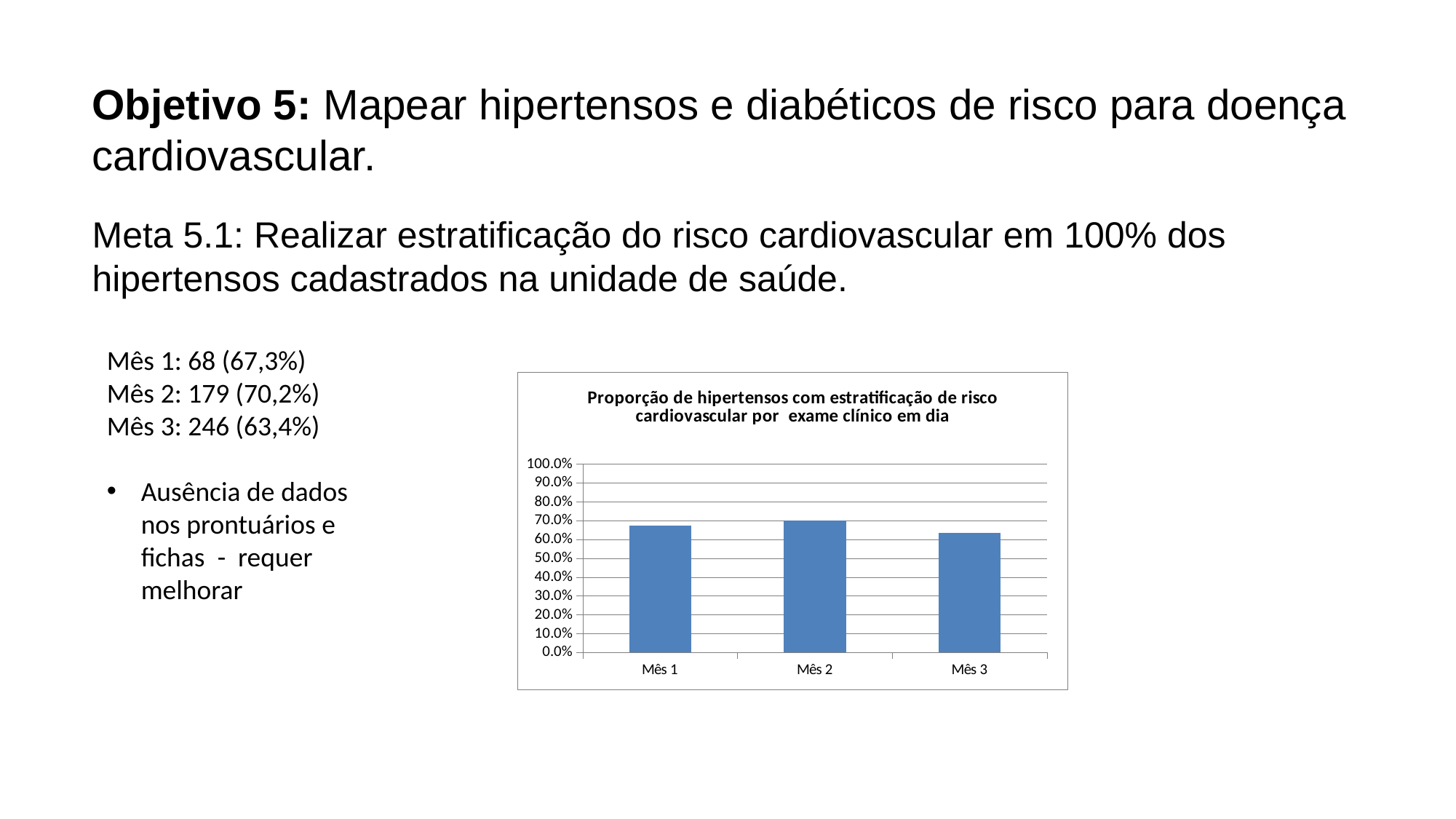
According to the slide, what proportion is shown for Mês 3? 63,4% Which month has the highest proportion of hypertensive patients with cardiovascular risk stratification? Mês 2 Do the values rise or fall from Mês 2 to Mês 3? fall Is the value for Mês 1 greater or less than 60.0%? greater What is the title of the chart? Proporção de hipertensos com estratificação de risco cardiovascular por exame clínico em dia Is the value for Mês 2 greater or less than 80.0%? less According to the slide, what proportion is shown for Mês 1? 67,3% Which is larger, the value for Mês 2 or the value for Mês 3? Mês 2 Which month has the lowest proportion of hypertensive patients with cardiovascular risk stratification? Mês 3 What kind of chart is shown on the slide? bar chart How many categories (months) are plotted on the chart? 3 Is the value for Mês 3 greater or less than 70.0%? less